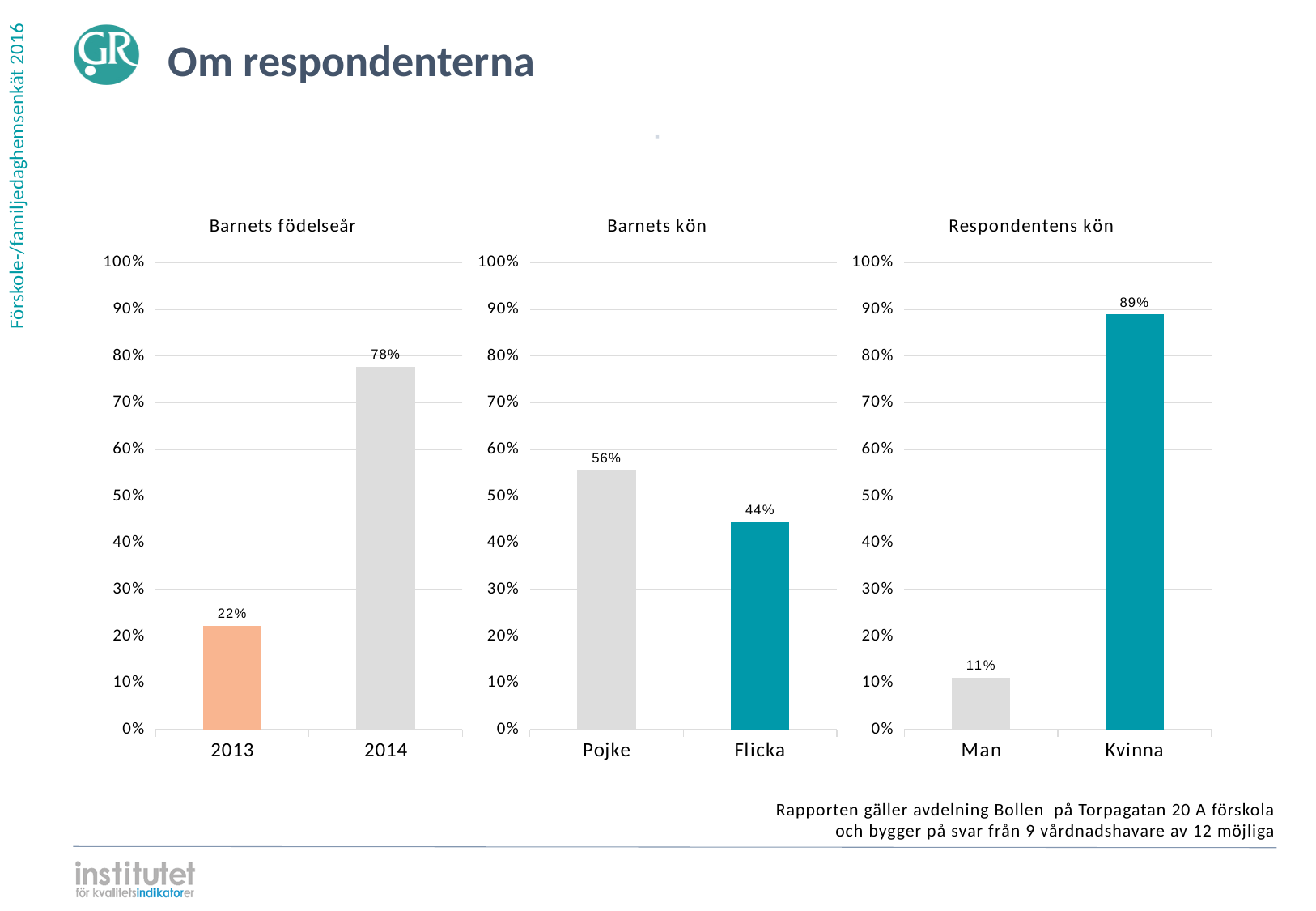
In the 'Barnets födelseår' chart, what is the value for 2014? 78% What kind of chart is the 'Barnets kön' chart? Bar chart In the 'Barnets kön' chart, what is the value for Pojke? 56% How many categories are shown in the 'Respondentens kön' chart? 2 In the 'Barnets födelseår' chart, what is the difference between the values for 2014 and 2013? 56% In the 'Barnets kön' chart, what is the value for Flicka? 44% In the 'Respondentens kön' chart, what is the value for Man? 11% In the 'Barnets kön' chart, which is larger, Pojke or Flicka? Pojke In the 'Respondentens kön' chart, what is the value for Kvinna? 89% In the 'Barnets födelseår' chart, what is the value for 2013? 22% In the 'Respondentens kön' chart, which category has the highest value? Kvinna In the 'Barnets kön' chart, which category has the lowest value? Flicka